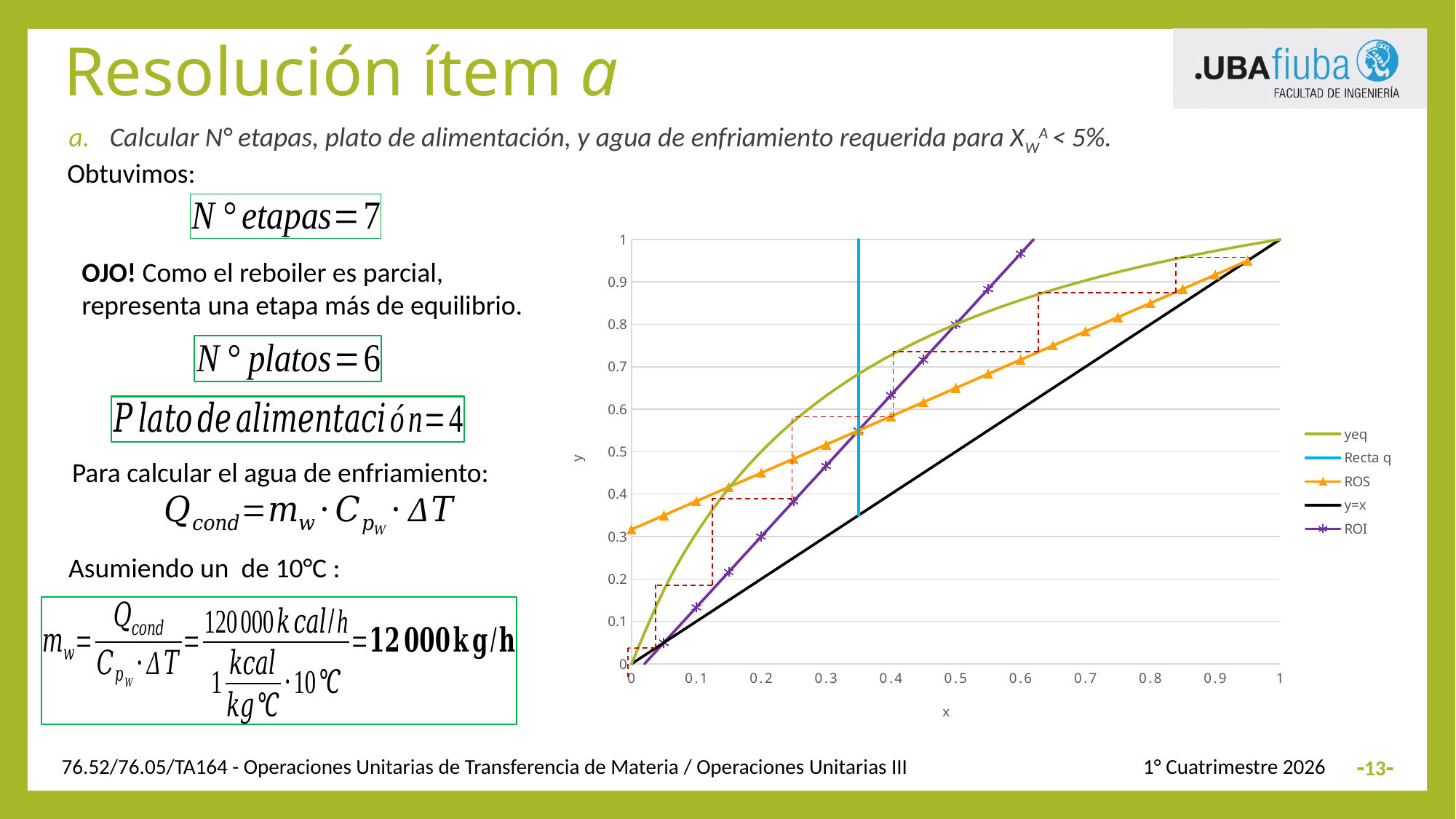
Which series in the legend is drawn as a vertical line? Recta q How many series does the chart legend list? 5 Do the values of the yeq series rise or fall as x increases? rise Is the value of the ROI series at x = 0.6 greater or less than 0.9? greater Is the value of the ROS series at x = 0.8 greater or less than 0.8? greater At x = 0.5, which series has the larger value, ROI or ROS? ROI What kind of chart is shown on the slide? line chart At x = 0.2, which series has the larger value, yeq or ROS? yeq Is the value of the ROS series at x = 0 greater or less than 0.4? less What is the label of the horizontal axis of the chart? x Do the values of the ROS series rise or fall as x increases? rise